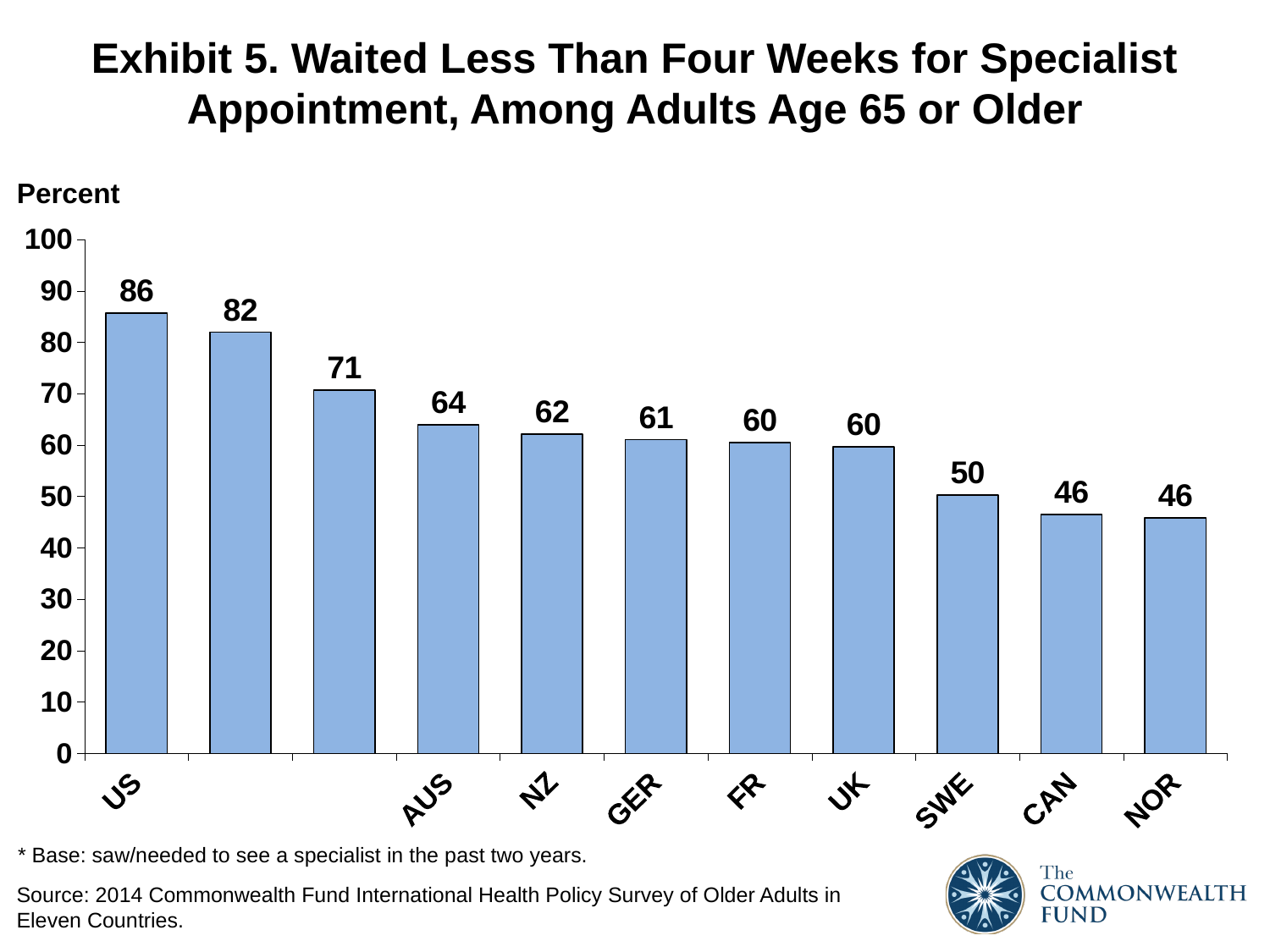
What is the value for US? 86 What is the difference between the values for UK and CAN? 14 Which has a larger value, GER or FR? GER Do the values rise or fall from left to right along the x axis? Fall What is the value for NZ? 62 What is the value for SWE? 50 What is the value for AUS? 64 What is the difference between the values for US and AUS? 22 Which country has the highest value? US What is the value for NOR? 46 What kind of chart is shown on the slide? Bar chart How many bars are shown in the chart? 11